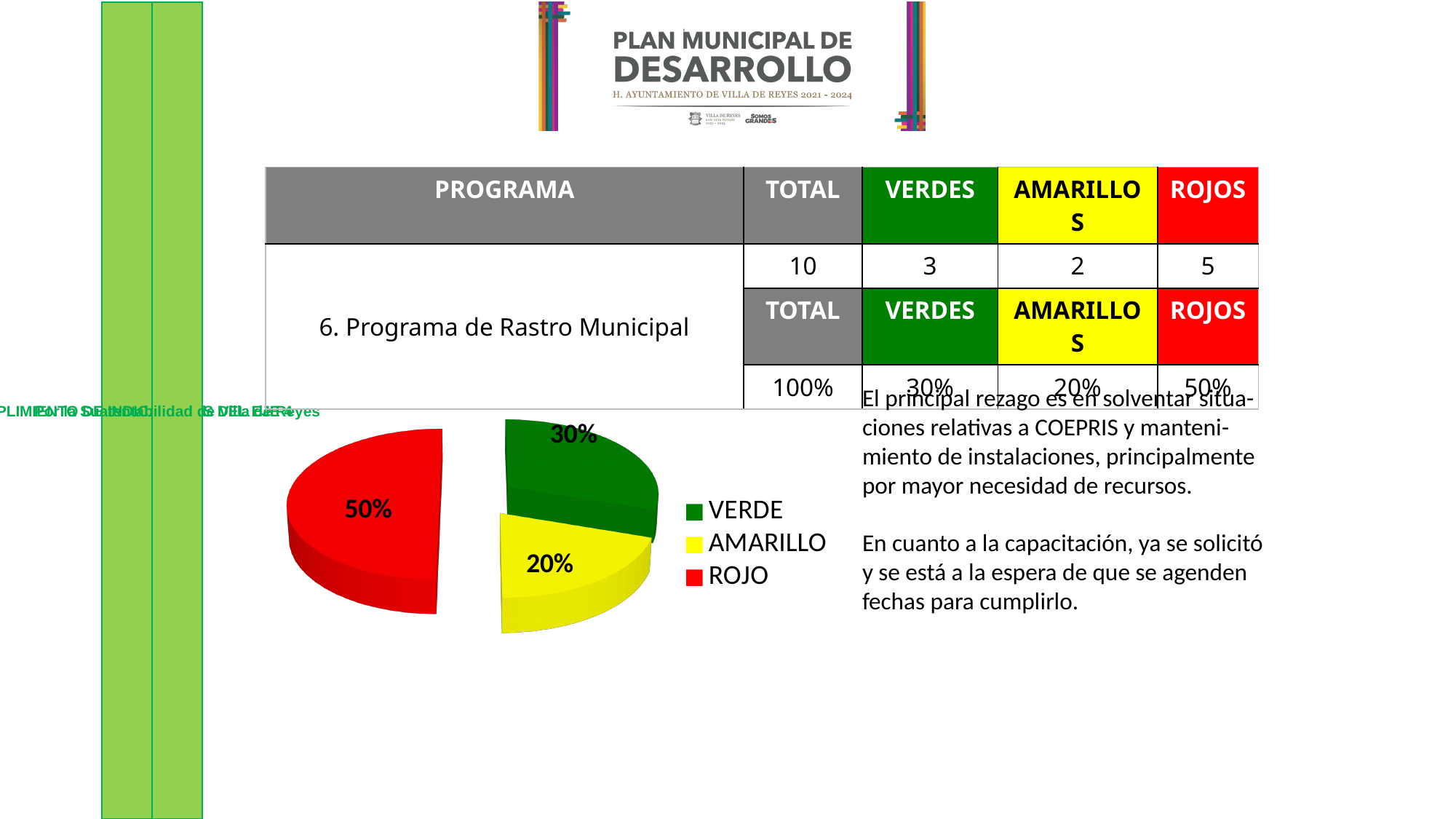
Which slice of the pie chart is the largest? ROJO What share of the pie does the VERDE slice represent? 30% What is the combined share of the VERDE and AMARILLO slices? 50% What colour is used for the ROJO slice in the pie chart? red What share of the pie does the AMARILLO slice represent? 20% What kind of chart is shown on the slide? pie chart Which slice of the pie chart is the smallest? AMARILLO What is the difference in percentage points between the ROJO and VERDE slices? 20% How many entries does the legend of the pie chart list? 3 How many slices does the pie chart have? 3 What share of the pie does the ROJO slice represent? 50% Which is larger in the pie chart, the VERDE slice or the AMARILLO slice? VERDE